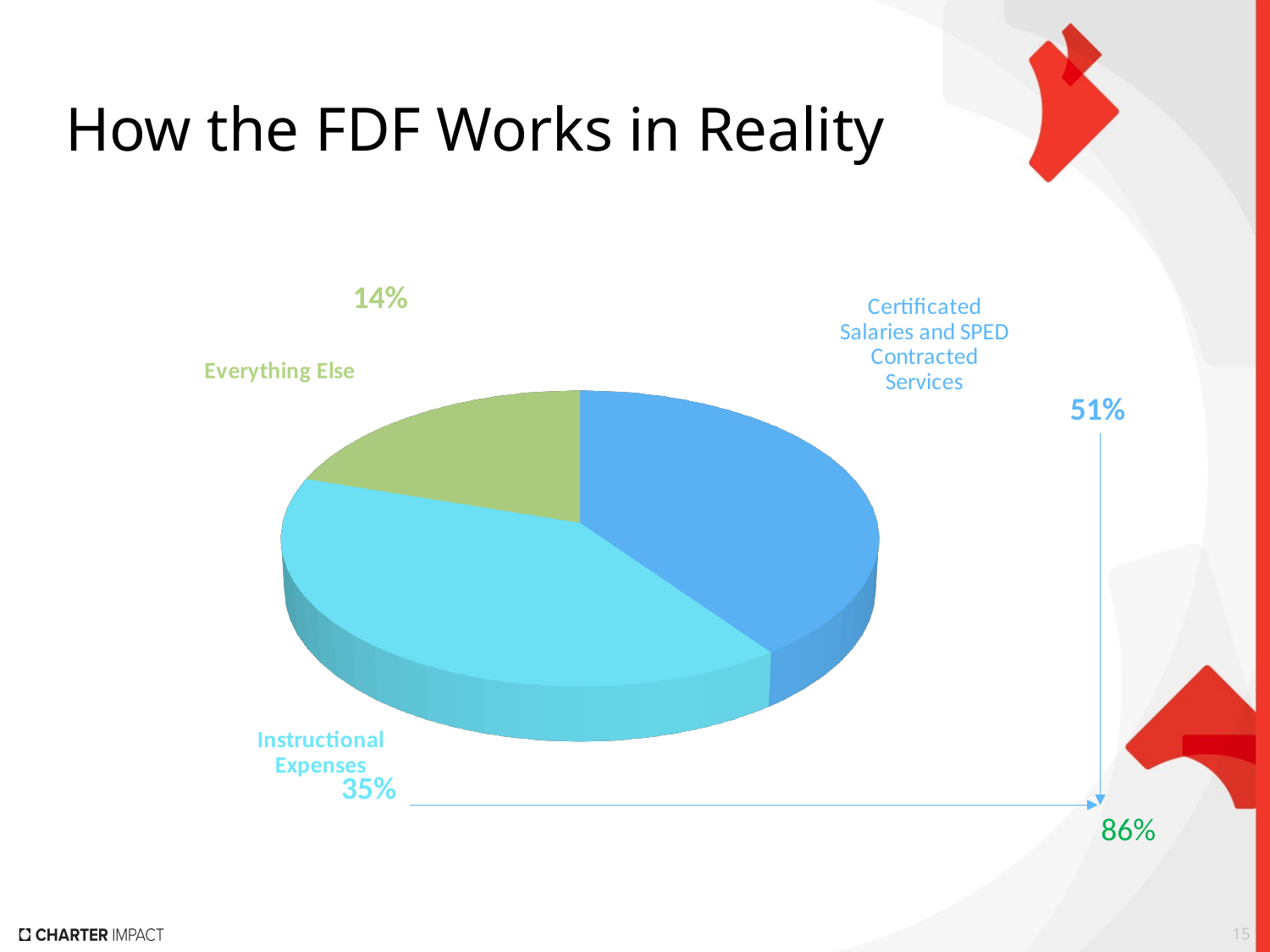
What colour is the Everything Else slice? green What is the difference in percentage points between Certificated Salaries and SPED Contracted Services and Instructional Expenses? 16 What share of the pie is Certificated Salaries and SPED Contracted Services? 51% Which is larger, Instructional Expenses or Everything Else? Instructional Expenses What kind of chart is shown on the slide? pie chart Which slice of the pie is the largest? Certificated Salaries and SPED Contracted Services Which slice of the pie is the smallest? Everything Else What combined percentage is shown at the end of the arrow spanning Certificated Salaries and SPED Contracted Services and Instructional Expenses? 86% What is the difference in percentage points between Instructional Expenses and Everything Else? 21 How many slices does the pie chart have? 3 What share of the pie is Everything Else? 14% What share of the pie is Instructional Expenses? 35%